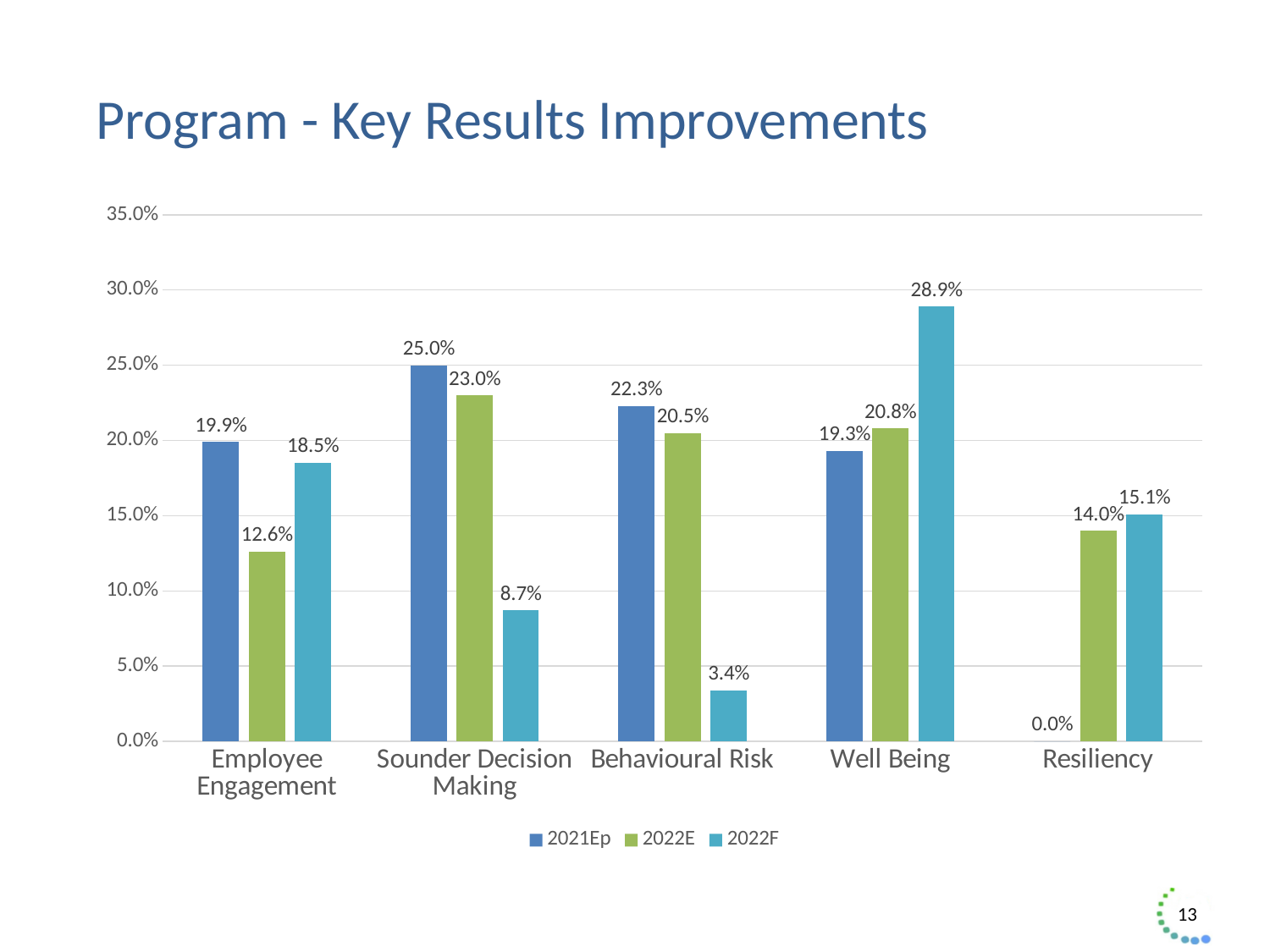
What is the title of the slide? Program - Key Results Improvements Which is larger for Employee Engagement: the 2021Ep value or the 2022F value? 2021Ep What is the 2021Ep value for Sounder Decision Making? 25.0% What is the 2022F value for Well Being? 28.9% What is the difference between the 2021Ep and 2022E values for Sounder Decision Making? 2.0% What is the 2022F value for Behavioural Risk? 3.4% How many series does the legend list? 3 What kind of chart is shown on the slide? Bar chart Which category has the lowest 2021Ep value? Resiliency How many categories are shown on the x axis? 5 Which category has the highest 2022F value? Well Being What is the 2022E value for Employee Engagement? 12.6%